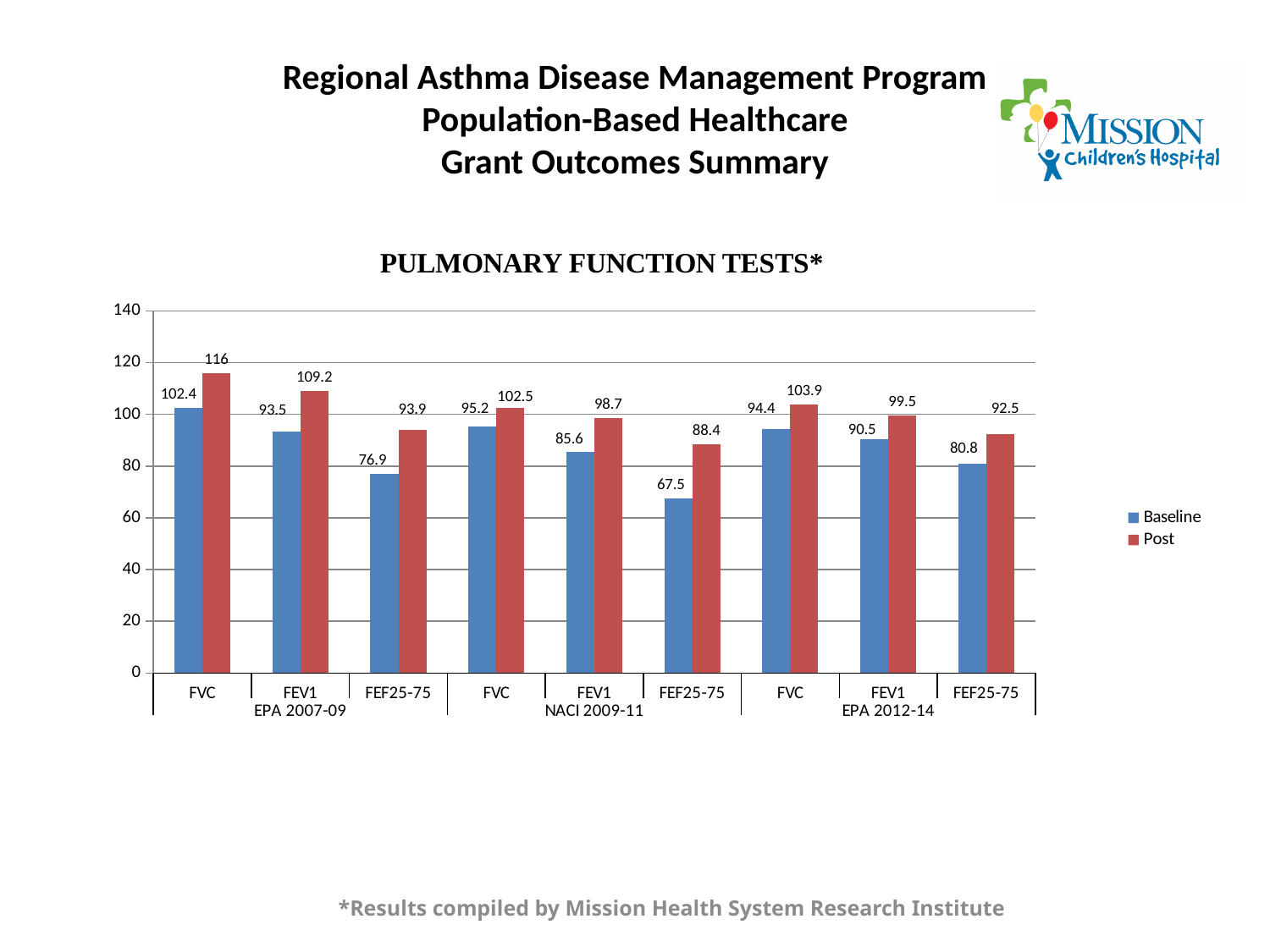
Which category has the lowest Baseline value? FEF25-75 (NACI 2009-11) What is the title of the chart? PULMONARY FUNCTION TESTS* What is the difference between the Post and Baseline values for FEF25-75 in the EPA 2007-09 group? 17 What kind of chart is shown on the slide? bar chart What is the Post value for FEF25-75 in the NACI 2009-11 group? 88.4 What is the Baseline value for FVC in the EPA 2007-09 group? 102.4 Which is larger: the Baseline value for FVC in NACI 2009-11 or the Baseline value for FVC in EPA 2012-14? FVC in NACI 2009-11 How many series does the legend list? 2 Is the Baseline value for FEF25-75 in the NACI 2009-11 group greater or less than 80? less Which category has the highest Post value? FVC (EPA 2007-09) How many categories are shown on the x axis? 9 What is the Post value for FEV1 in the EPA 2012-14 group? 99.5